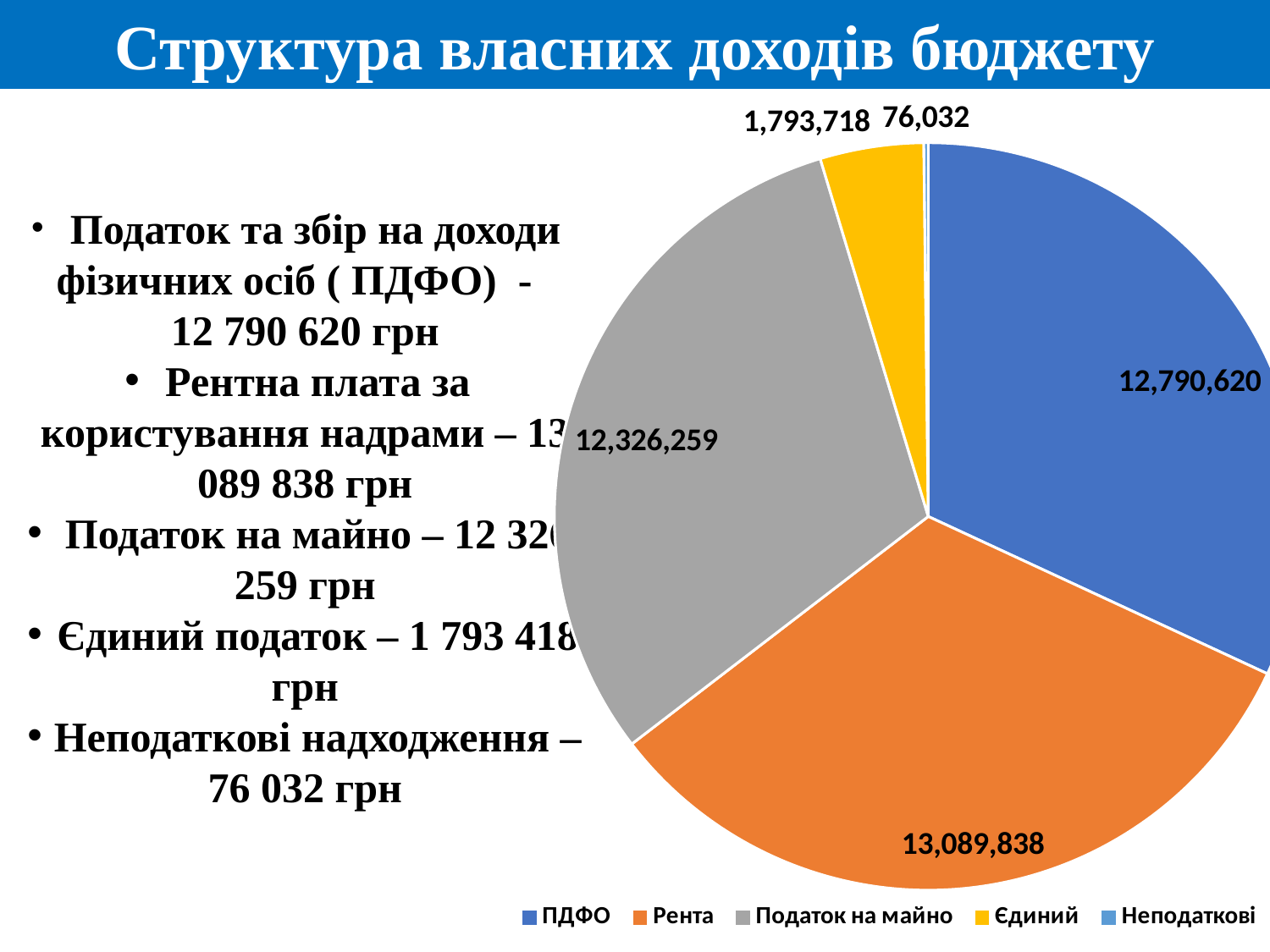
How many slices does the pie chart have? 5 What is the value shown for Неподаткові? 76,032 Which category has the largest slice of the pie? Рента What is the value shown for Податок на майно? 12,326,259 What is the title of the chart on the slide? Структура власних доходів бюджету What is the difference between the values for Рента and ПДФО? 299,218 Which is larger, the value for ПДФО or the value for Податок на майно? ПДФО What type of chart is shown on the slide? pie chart Which category has the smallest slice of the pie? Неподаткові What is the value shown for Рента? 13,089,838 What is the value shown for ПДФО? 12,790,620 What is the value shown for Єдиний? 1,793,718